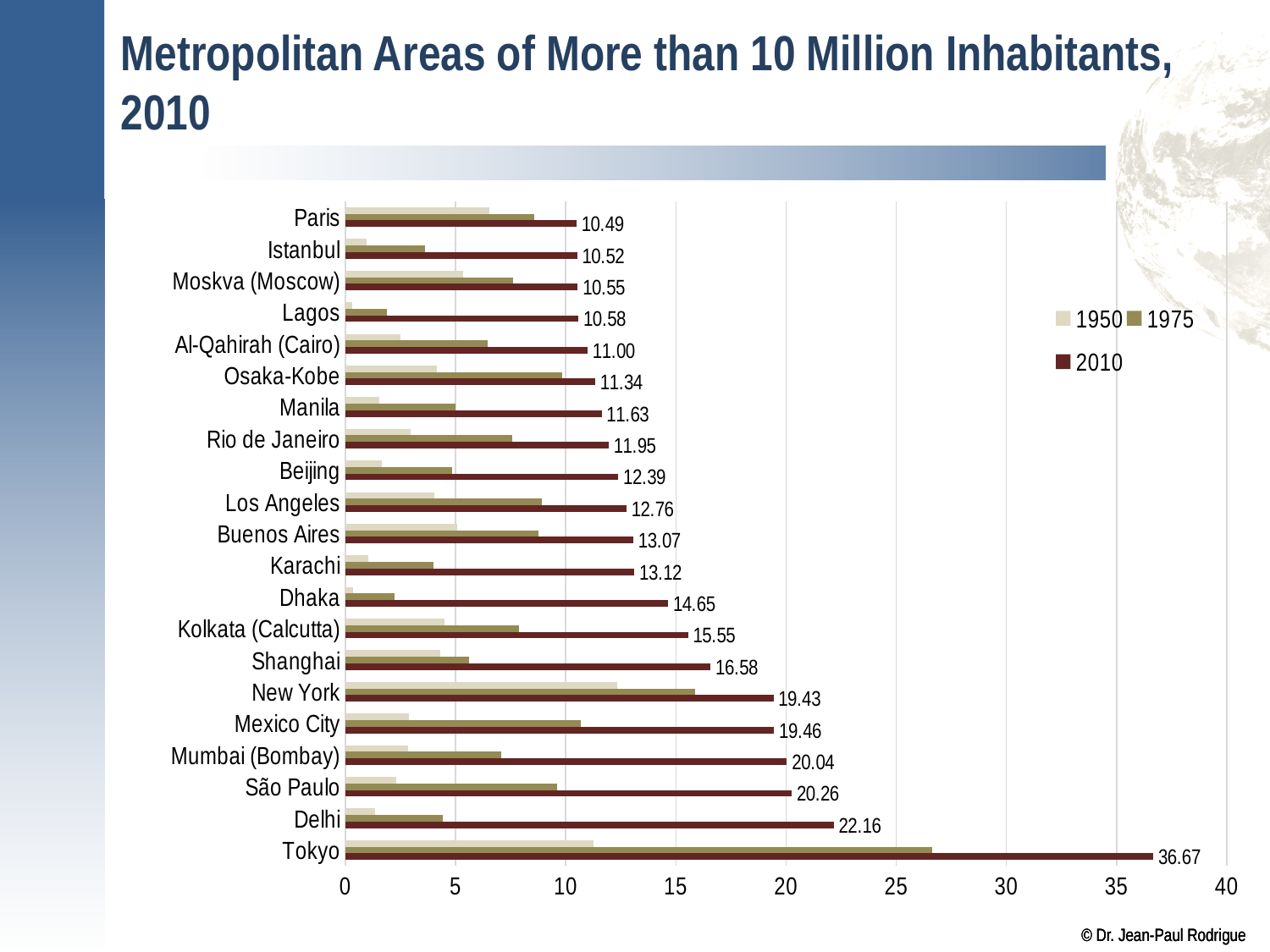
How many metropolitan areas are shown on the chart? 21 What is the 2010 value for Tokyo? 36.67 What kind of chart is shown on the slide? bar chart Is the 1975 value for Tokyo greater or less than 25? greater How many series does the legend list? 3 What is the 2010 value for Delhi? 22.16 Which has the larger 2010 value, Shanghai or Kolkata (Calcutta)? Shanghai Is the 1950 value for New York greater or less than 10? greater Which years are listed in the chart's legend? 1950, 1975, 2010 What is the difference between the 2010 values for Tokyo and Delhi? 14.51 Which metropolitan area has the lowest 2010 value? Paris Which metropolitan area has the highest 2010 value? Tokyo